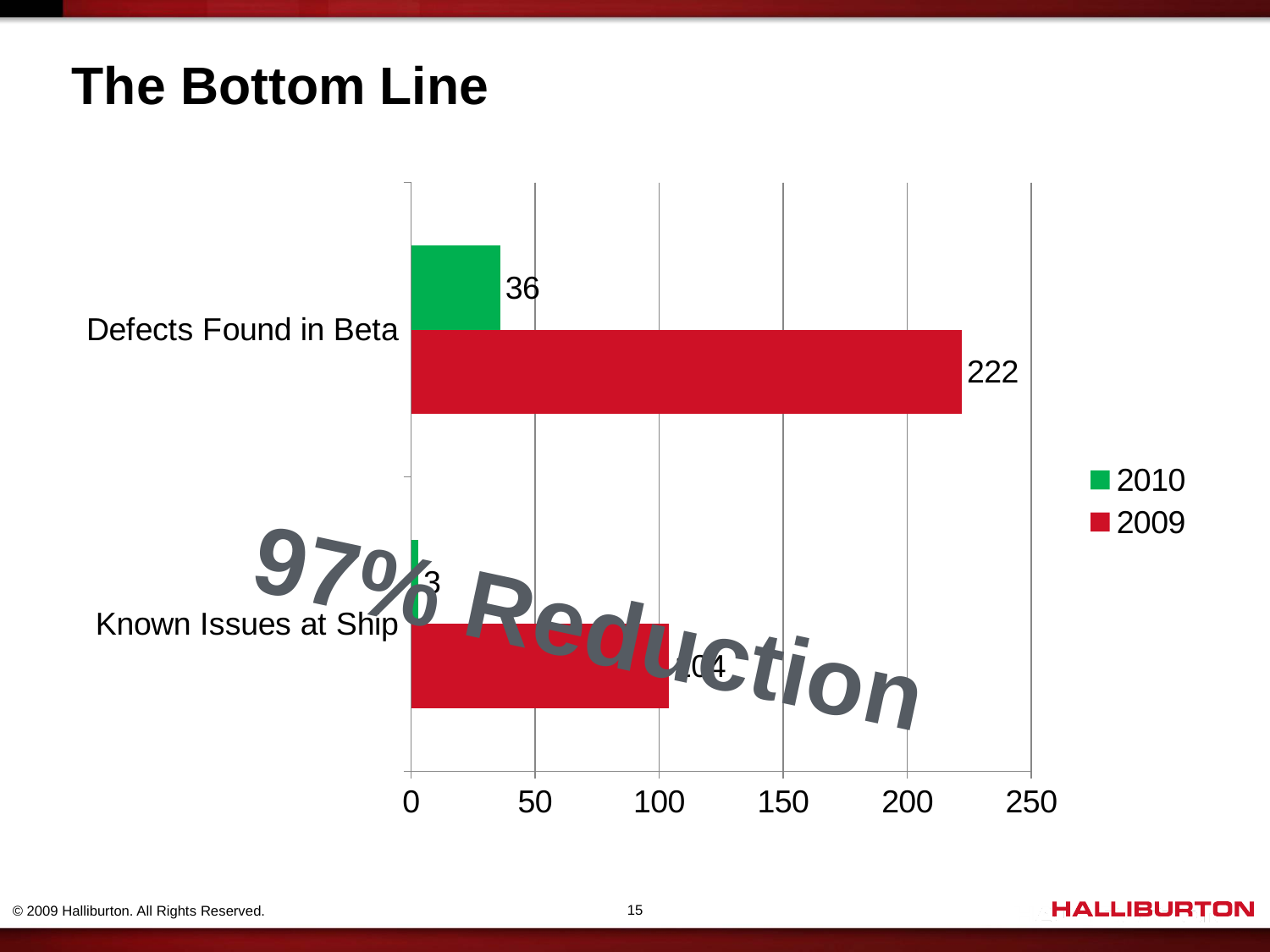
How many series does the legend list? 2 What is the value for Defects Found in Beta in the 2009 series? 222 Is the 2009 value for Defects Found in Beta greater or less than 200? greater How many categories are shown on the chart? 2 What kind of chart is shown on the slide? Bar chart Which category has the highest value in the 2009 series? Defects Found in Beta Is the 2010 value for Known Issues at Ship greater or less than 50? less Which series is shown in green in the legend? 2010 Is the 2009 value for Known Issues at Ship greater or less than 150? less For Defects Found in Beta, which series has the larger value, 2009 or 2010? 2009 What is the value for Defects Found in Beta in the 2010 series? 36 What is the difference between the 2009 and 2010 values for Defects Found in Beta? 186